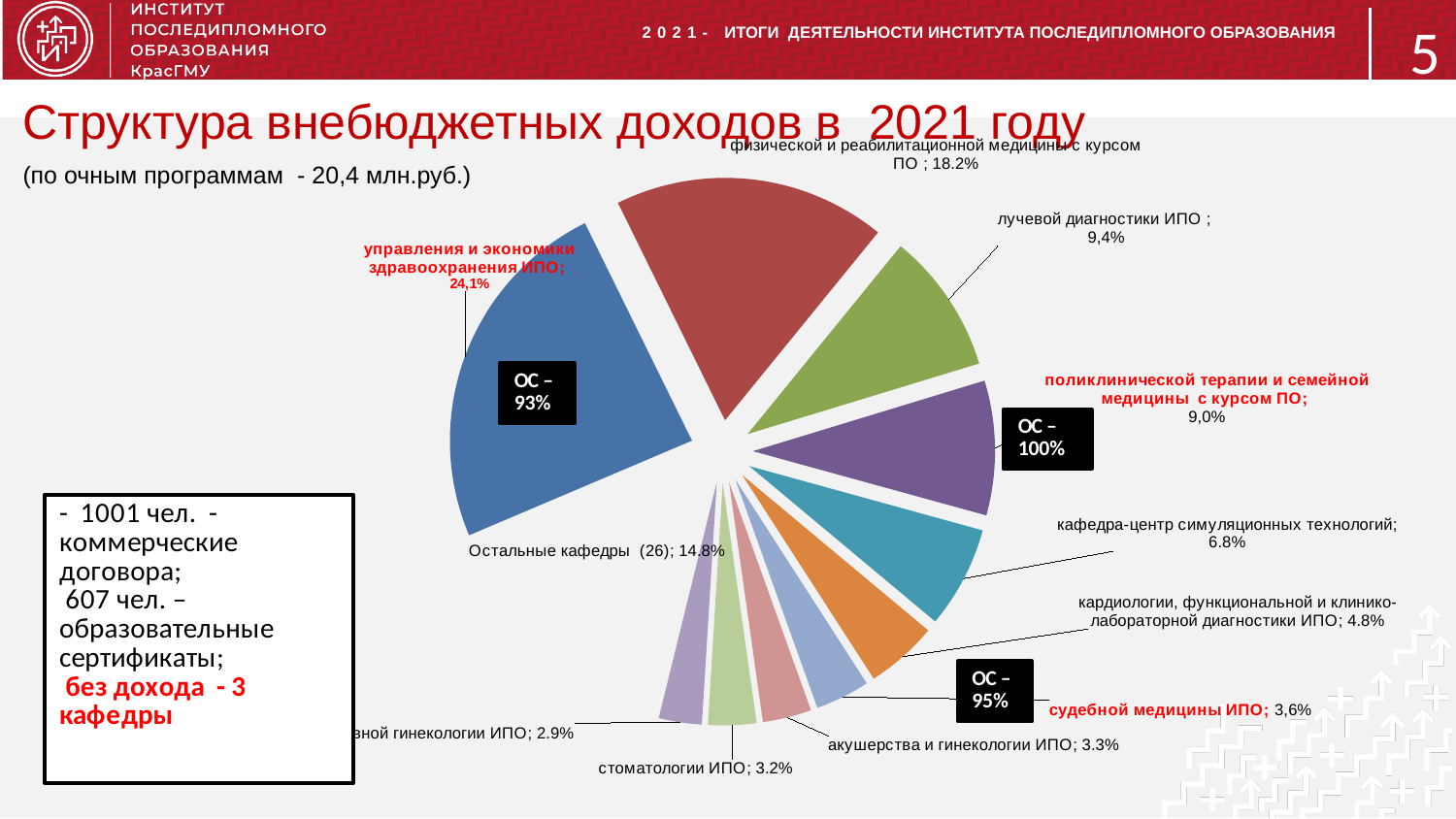
What share of the pie does the slice for Остальные кафедры (26) have? 14.8% What kind of chart is shown on the slide? pie chart Which labelled slice has the largest share of the pie? управления и экономики здравоохранения ИПО Which is larger: the share for поликлинической терапии и семейной медицины с курсом ПО or the share for кардиологии, функциональной и клинико-лабораторной диагностики ИПО? поликлинической терапии и семейной медицины с курсом ПО What is the difference between the share for акушерства и гинекологии ИПО (3.3%) and the share for стоматологии ИПО (3.2%)? 0.1% What share of the pie does the slice for судебной медицины ИПО have? 3,6% What share of the pie does the slice for лучевой диагностики ИПО have? 9,4% What is the title of the chart on the slide? Структура внебюджетных доходов в 2021 году What is the difference between the share for физической и реабилитационной медицины с курсом ПО (18.2%) and the share for лучевой диагностики ИПО (9,4%)? 8.8%